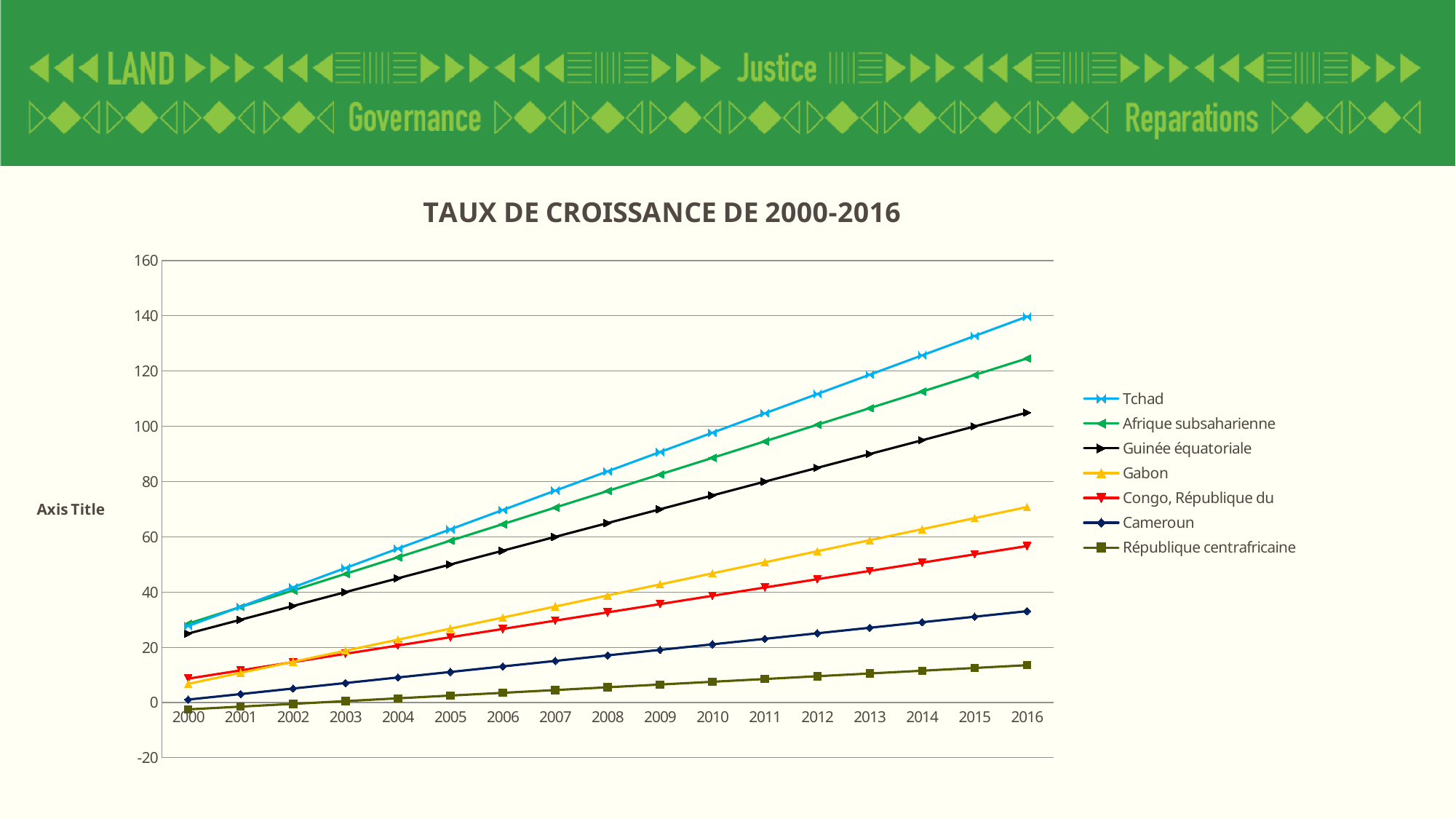
Do the values for Tchad rise or fall from 2000 to 2016? rise Which series is drawn in red? Congo, République du Which series has the highest value in 2016? Tchad Is the value for République centrafricaine in 2016 greater or less than 20? less How many series does the legend list? 7 Is the value for Tchad in 2016 greater or less than 120? greater Which series has the lowest value in 2016? République centrafricaine How many years are shown along the x axis? 17 What is the title of the chart? TAUX DE CROISSANCE DE 2000-2016 In 2016, which is larger: the value for Afrique subsaharienne or the value for Guinée équatoriale? Afrique subsaharienne Is the value for Cameroun in 2016 greater or less than 20? greater What kind of chart is shown on the slide? line chart